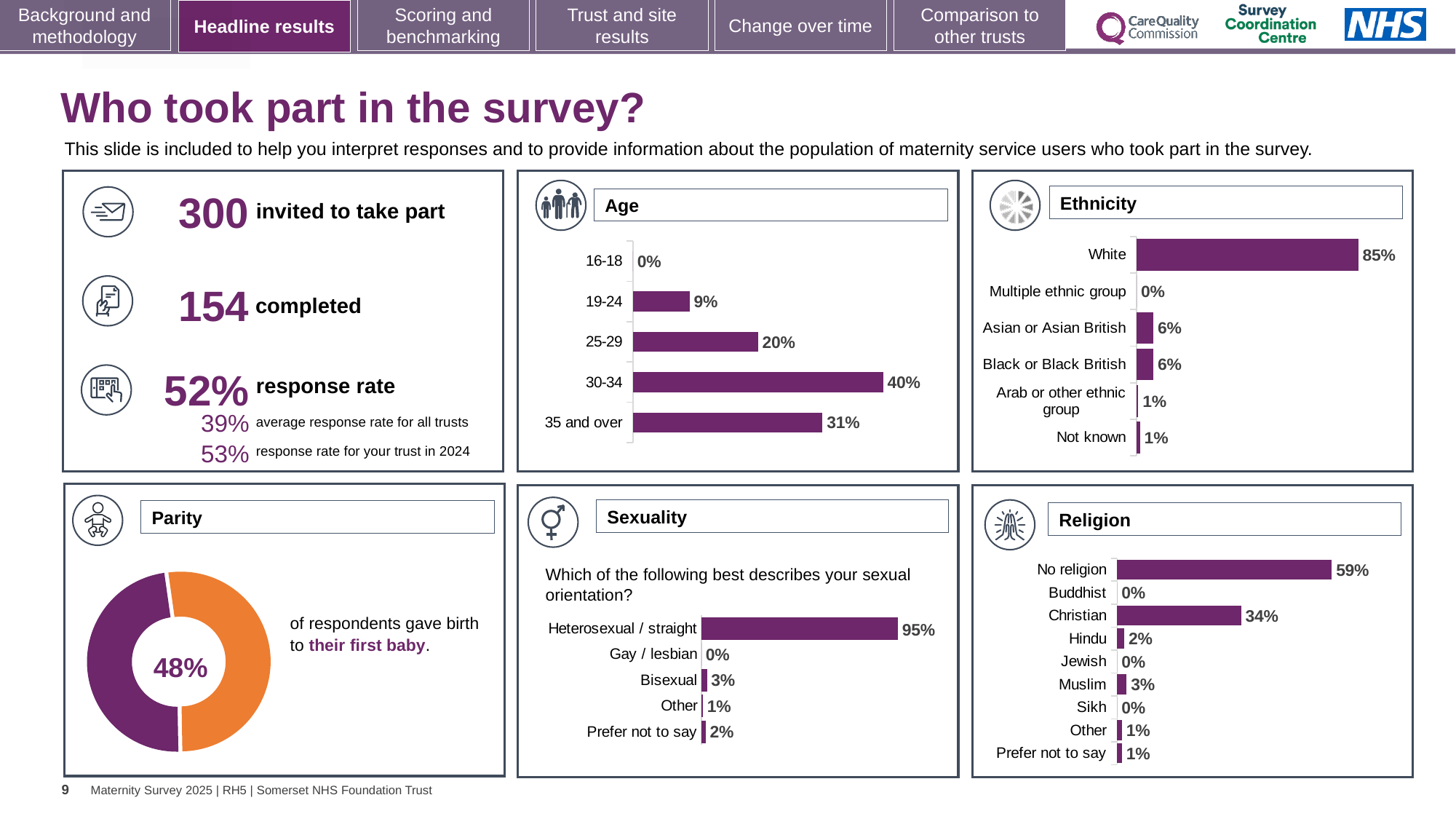
In the Ethnicity chart, what percentage of respondents were White? 85% What kind of chart is the Parity chart? Doughnut chart In the Religion chart, what percentage of respondents were Christian? 34% In the Religion chart, what is the difference between No religion and Christian? 25% In the Age chart, what is the difference between the 30-34 and 35 and over percentages? 9% In the Parity chart, what percentage of respondents gave birth to their first baby? 48% In the Sexuality chart, which category has the highest percentage? Heterosexual / straight In the Sexuality chart, what percentage of respondents described themselves as Bisexual? 3% In the Age chart, which age group has the highest percentage? 30-34 In the Age chart, what percentage of respondents were aged 30-34? 40% In the Ethnicity chart, how many ethnicity categories are shown? 6 In the Ethnicity chart, which is larger: Asian or Asian British or Arab or other ethnic group? Asian or Asian British